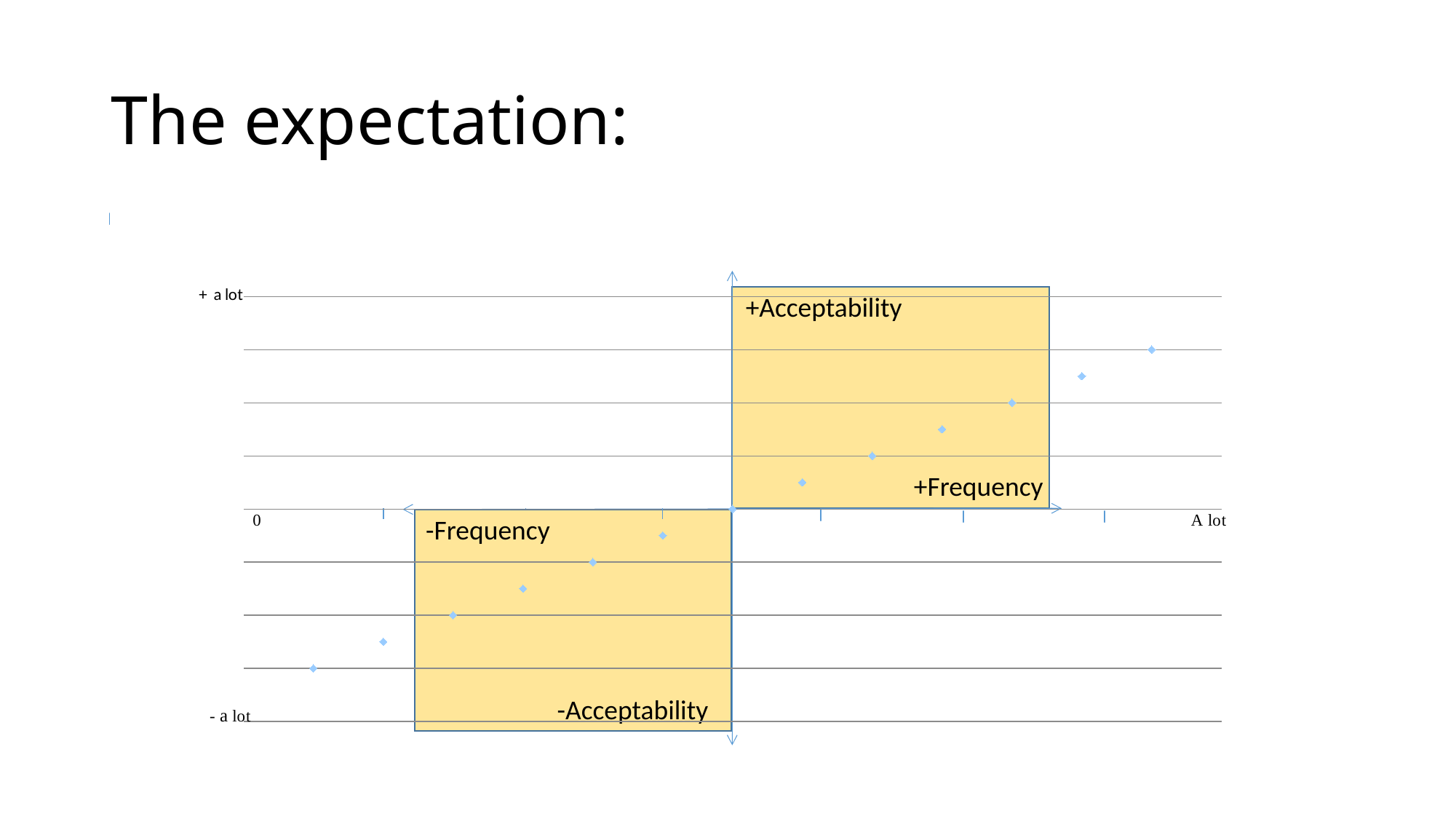
What kind of chart is shown on the slide? scatter chart What is the title of the slide containing the chart? The expectation: What label appears at the right end of the x axis? A lot Are the points in the lower-left yellow box above or below the horizontal axis? below Which is higher on the y axis: the rightmost point or the leftmost point? the rightmost point Do the plotted points rise or fall as you move from left to right along the x axis? rise